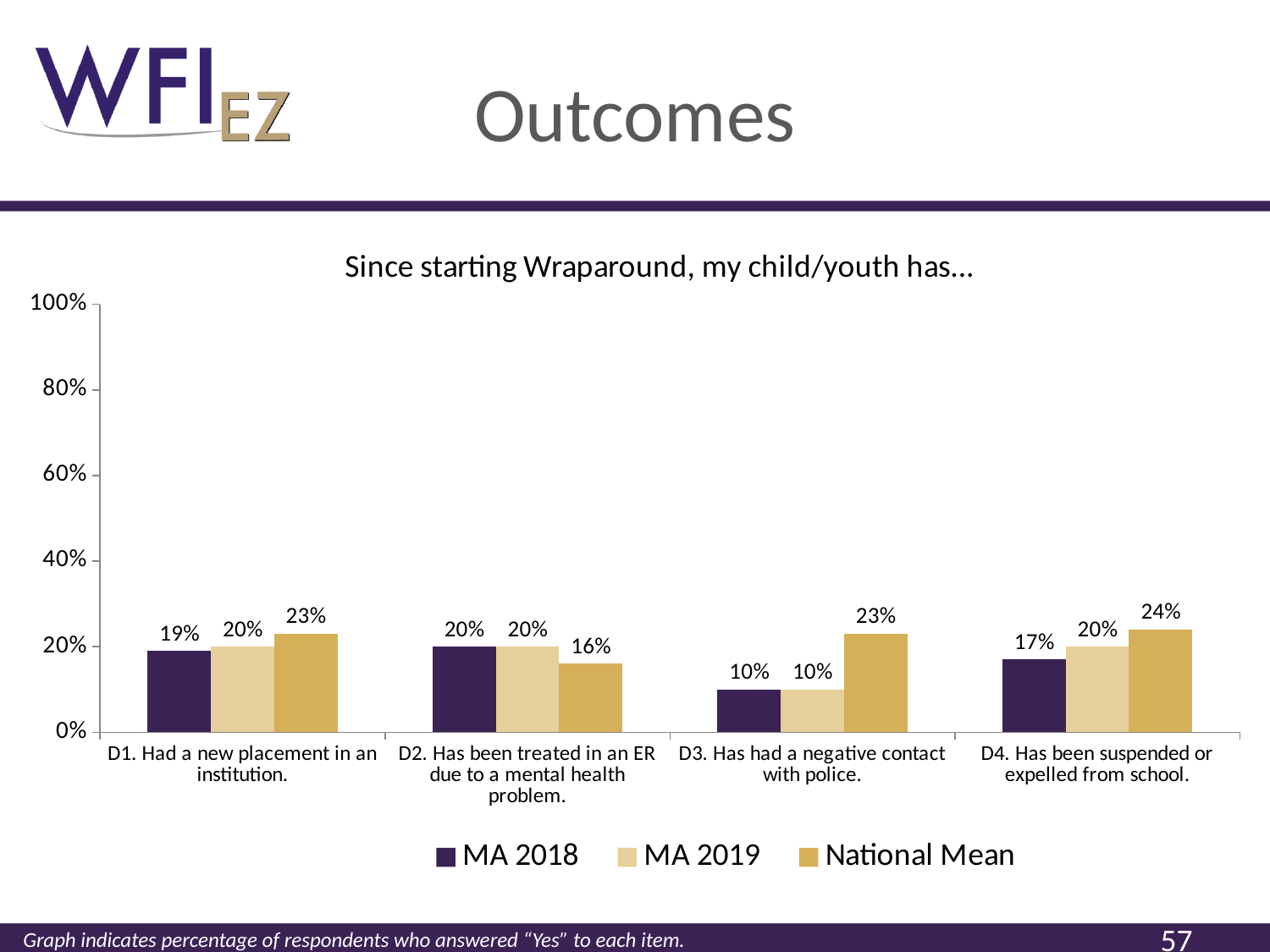
What kind of chart is shown on the slide? Bar chart What is the National Mean value for D2. Has been treated in an ER due to a mental health problem? 16% What is the title of the chart? Since starting Wraparound, my child/youth has… What is the MA 2018 value for D1. Had a new placement in an institution? 19% How many categories are shown on the x axis? 4 What is the MA 2019 value for D3. Has had a negative contact with police? 10% What is the National Mean value for D4. Has been suspended or expelled from school? 24% Which category has the highest National Mean value? D4. Has been suspended or expelled from school. How many series does the legend list? 3 What is the difference between the National Mean and MA 2019 values for D3. Has had a negative contact with police? 13% For D2. Has been treated in an ER due to a mental health problem, which is larger: the MA 2018 value or the National Mean value? MA 2018 Which category has the lowest MA 2018 value? D3. Has had a negative contact with police.